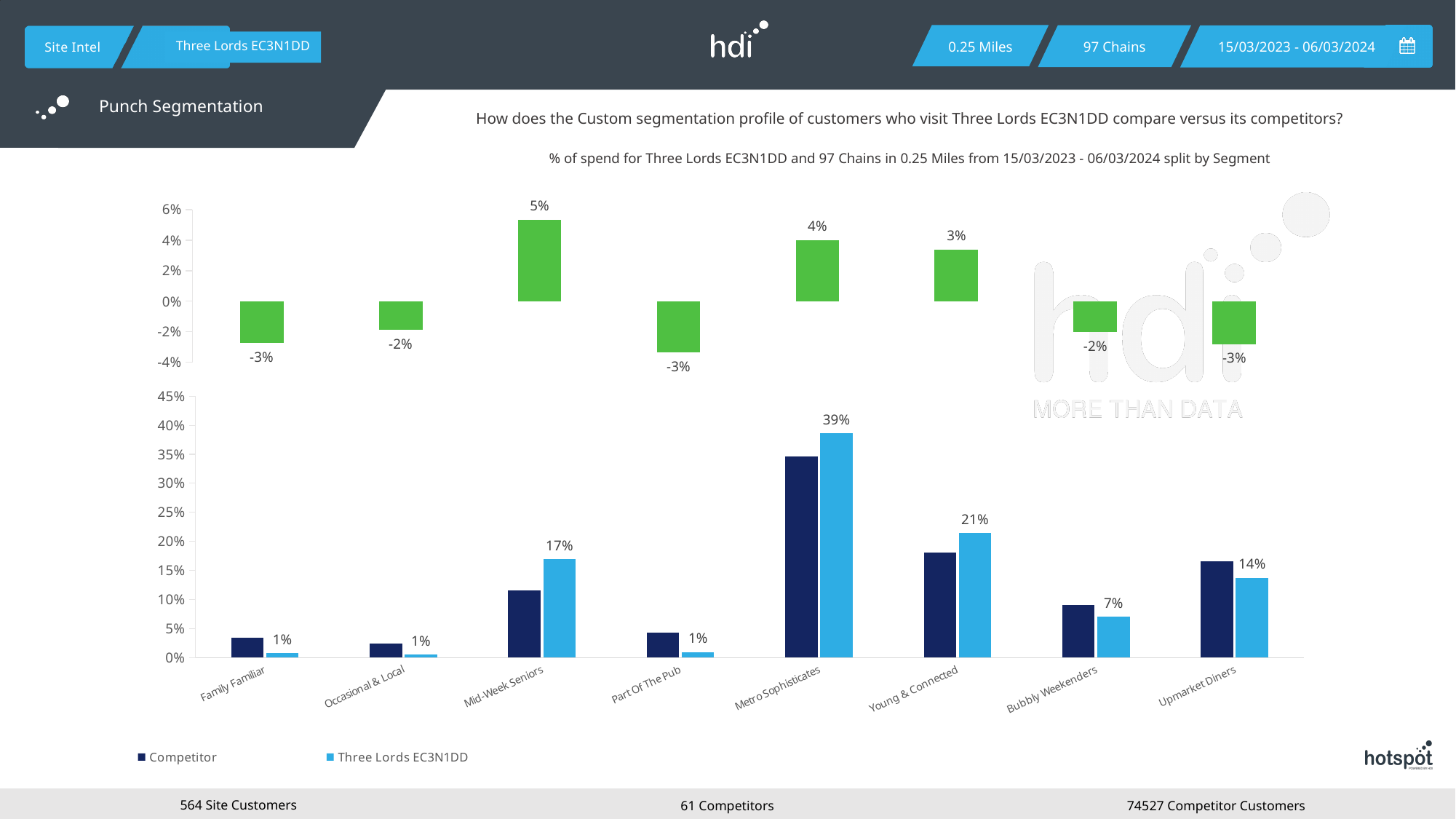
In the bottom chart, for Upmarket Diners, which is larger: the Competitor bar or the Three Lords EC3N1DD bar? Competitor In the bottom chart, is the Competitor value for Metro Sophisticates greater or less than 30%? greater In the bottom chart, is the Competitor value for Mid-Week Seniors greater or less than 15%? less In the bottom chart, what is the difference between the Three Lords EC3N1DD values for Metro Sophisticates and Young & Connected? 18% In the bottom chart, what is the Three Lords EC3N1DD value for Metro Sophisticates? 39% In the top chart, what is the value shown for Upmarket Diners? -3% In the bottom chart, what is the Three Lords EC3N1DD value for Young & Connected? 21% In the top chart, which segment has the highest value? Mid-Week Seniors How many series does the legend of the bottom chart list? 2 How many segments are shown on the x axis of the bottom chart? 8 In the top chart, what is the value shown for Mid-Week Seniors? 5% In the bottom chart, which segment has the highest Three Lords EC3N1DD value? Metro Sophisticates